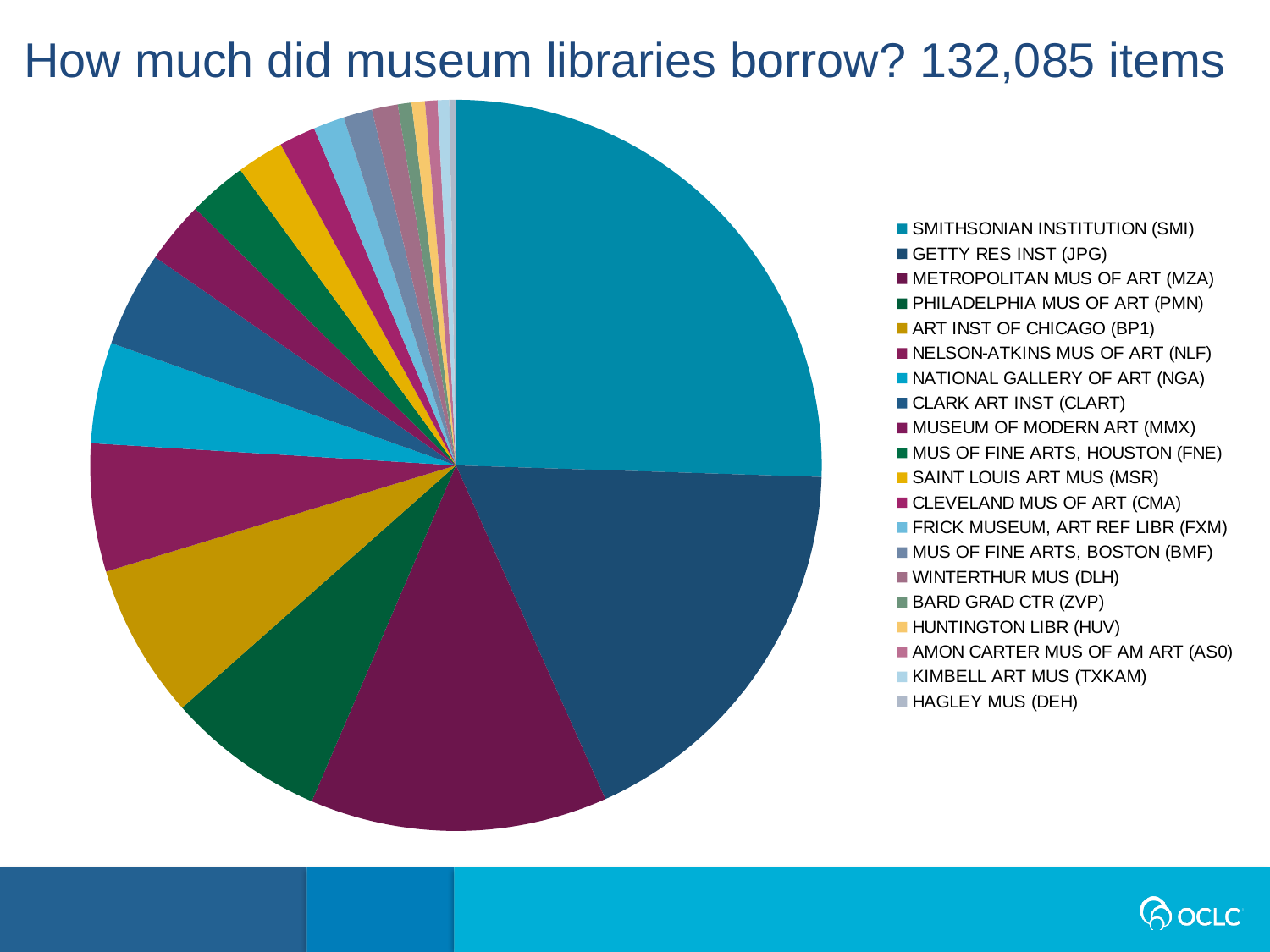
Which slice is larger, METROPOLITAN MUS OF ART (MZA) or CLARK ART INST (CLART)? METROPOLITAN MUS OF ART (MZA) Which slice is larger, GETTY RES INST (JPG) or ART INST OF CHICAGO (BP1)? GETTY RES INST (JPG) Which slice is larger, PHILADELPHIA MUS OF ART (PMN) or SMITHSONIAN INSTITUTION (SMI)? SMITHSONIAN INSTITUTION (SMI) Which institution has the largest slice of the pie chart? SMITHSONIAN INSTITUTION (SMI) What is the title of the chart on the slide? How much did museum libraries borrow? 132,085 items Which institution is listed first in the legend? SMITHSONIAN INSTITUTION (SMI) How many institutions are listed in the legend of the pie chart? 20 What kind of chart is shown on the slide? pie chart According to the slide title, how many items did museum libraries borrow in total? 132,085 items